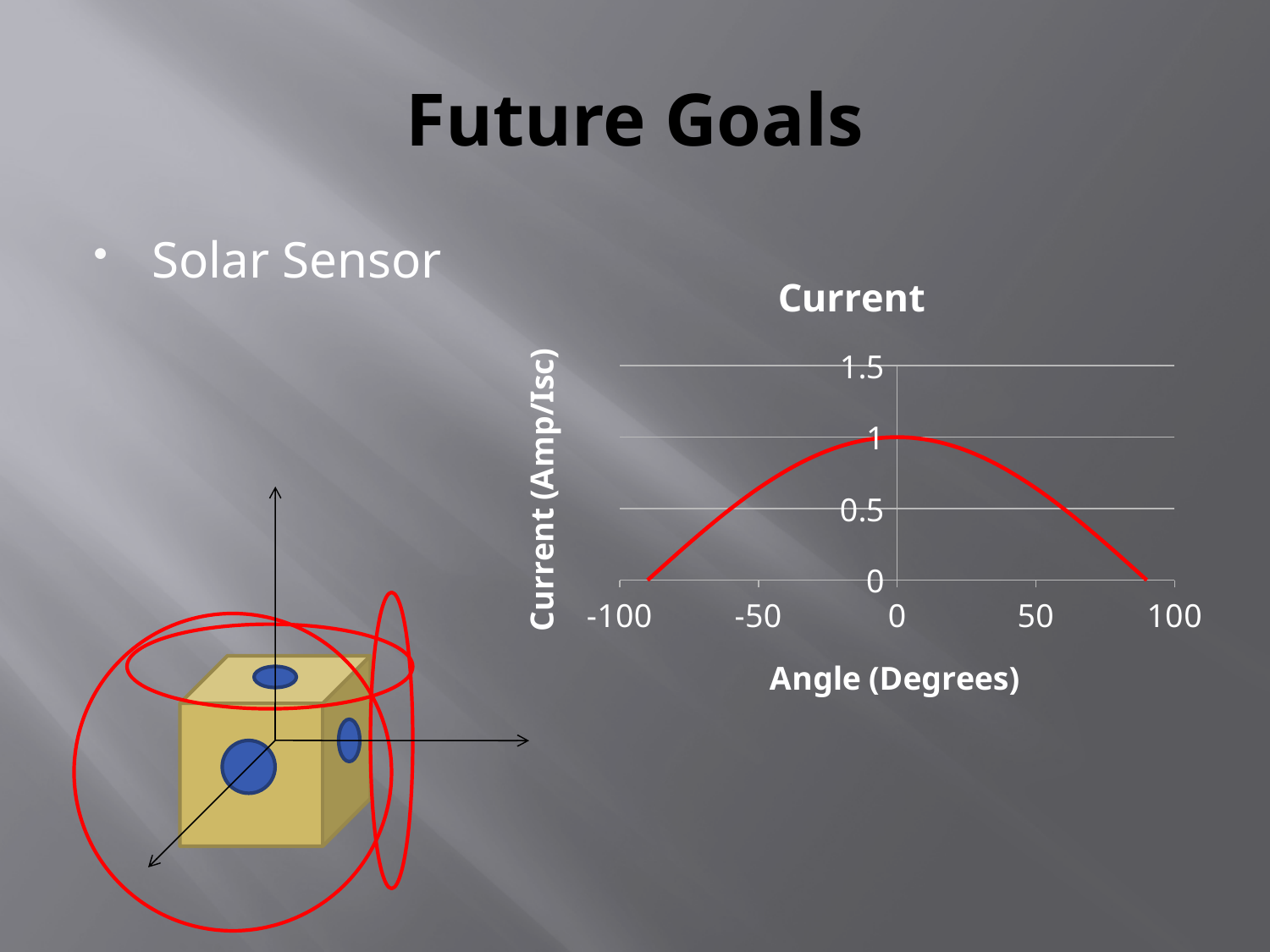
Is the current at an angle of 0 degrees greater or less than 1.5? less Does the current rise or fall as the angle increases from -100 to 0 degrees? rise Does the current rise or fall as the angle increases from 0 to 100 degrees? fall Is the current at an angle of -50 degrees greater or less than 1? less At which angle does the current reach its highest value? 0 Is the current at an angle of 50 degrees greater or less than 0.5? greater What is the label of the x axis of the chart? Angle (Degrees) What is the current value at an angle of 0 degrees? 1 What is the title of the chart? Current Which is larger, the current at -50 degrees or the current at 0 degrees? 0 degrees What kind of chart is shown on the slide? line chart